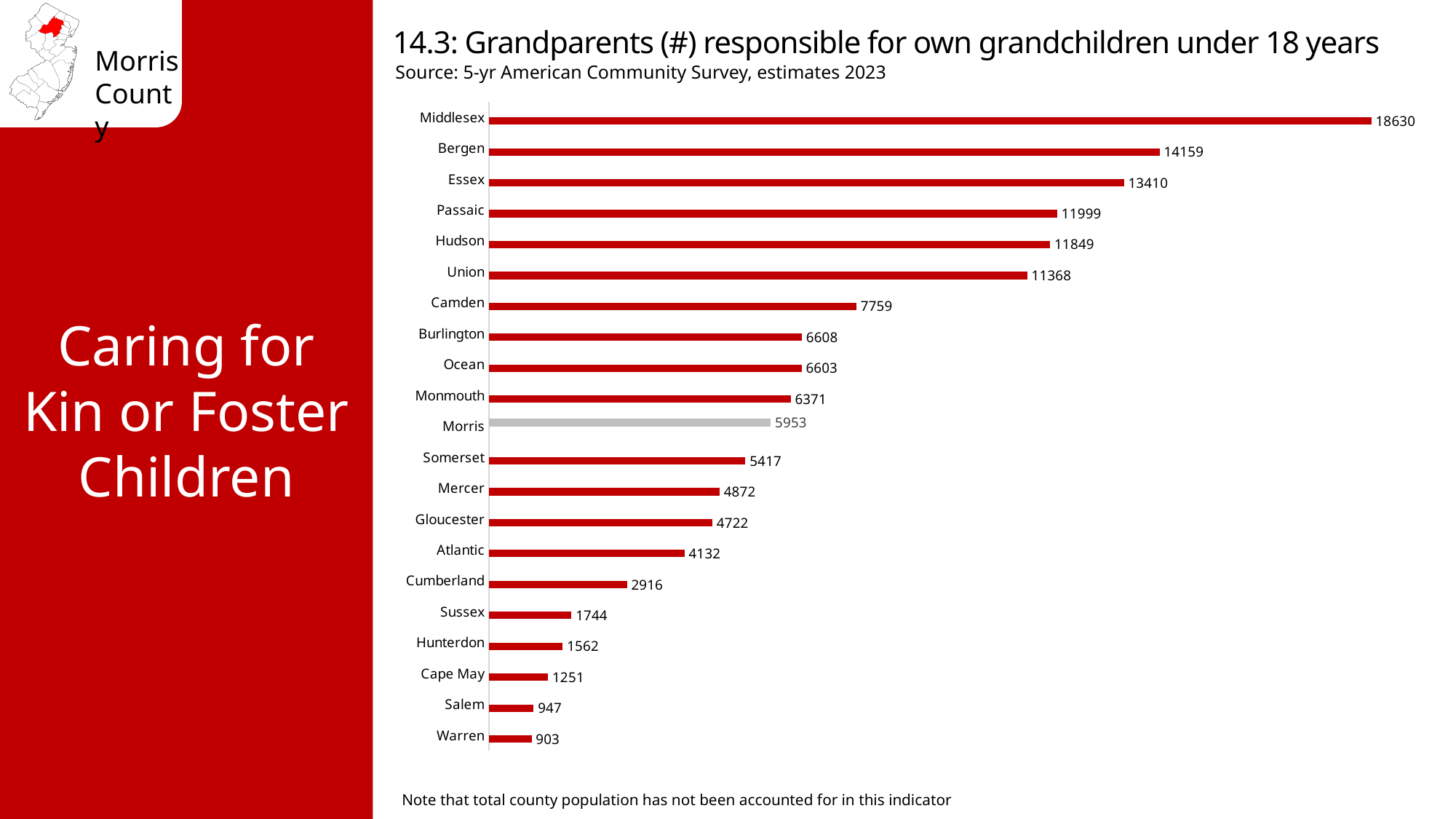
Which county has the lowest value? Warren Which is larger, the value for Sussex or the value for Hunterdon? Sussex Which county's bar is shown in grey rather than red? Morris What is the value for Middlesex? 18630 Which is larger, the value for Camden or the value for Monmouth? Camden Which county has the highest value? Middlesex What is the value for Cumberland? 2916 What is the difference between the values for Morris and Somerset? 536 What kind of chart is shown on the slide? Bar chart What is the difference between the values for Bergen and Essex? 749 What is the value for Morris? 5953 How many counties are shown in the chart? 21